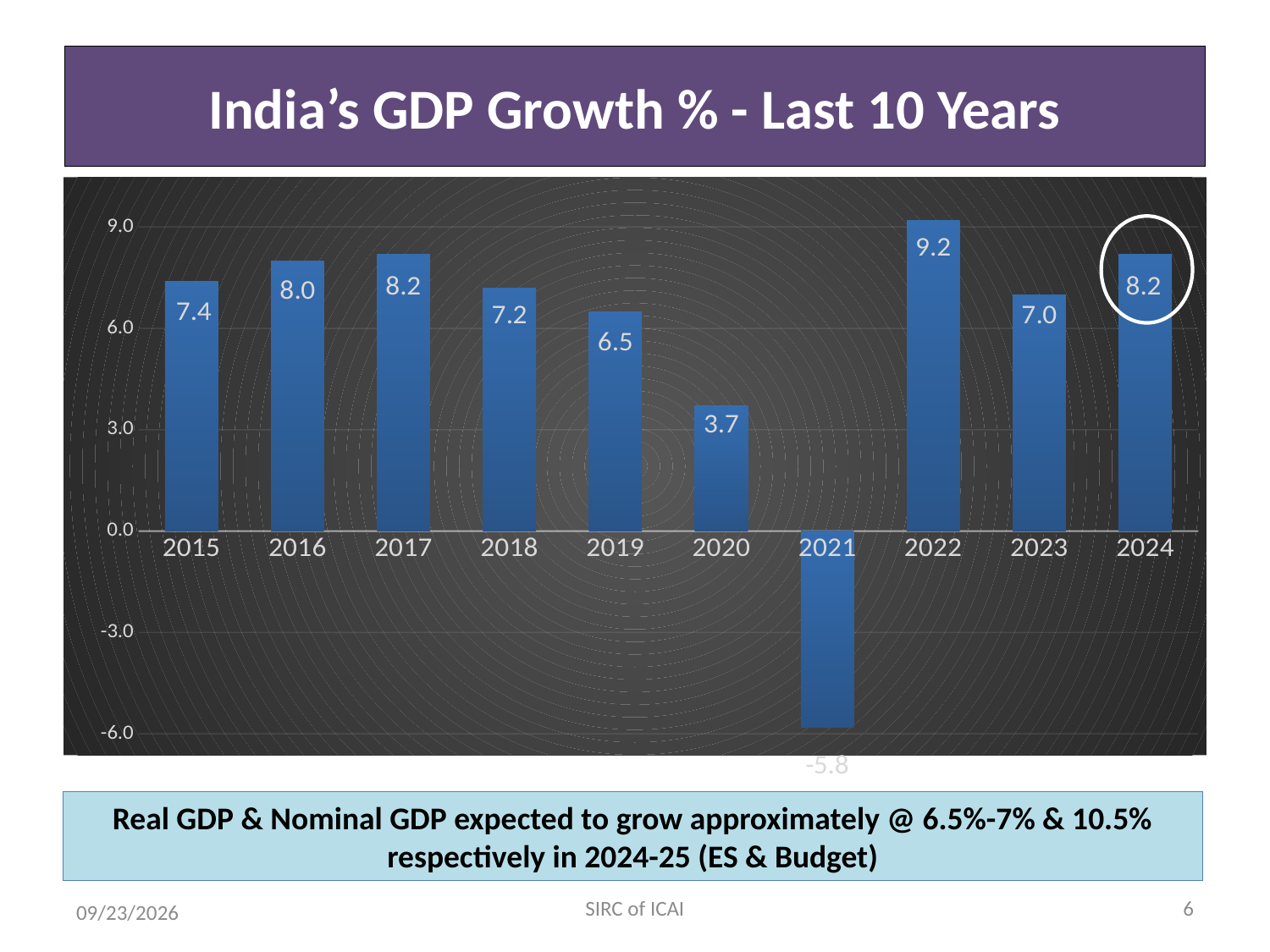
How many years are shown on the x axis of the chart? 10 Do the GDP growth values rise or fall from 2017 to 2020? Fall Which year has the highest GDP growth value? 2022 What is the GDP growth value shown for 2021? -5.8 What is the title of the chart on the slide? India's GDP Growth % - Last 10 Years Is the value for 2019 greater or less than 6.0? greater What is the difference between the GDP growth values for 2022 and 2023? 2.2 What is the GDP growth value shown for 2015? 7.4 Which year has the larger GDP growth value, 2016 or 2020? 2016 What is the GDP growth value shown for 2024? 8.2 What kind of chart is shown on the slide? Bar chart Which year has the lowest GDP growth value? 2021